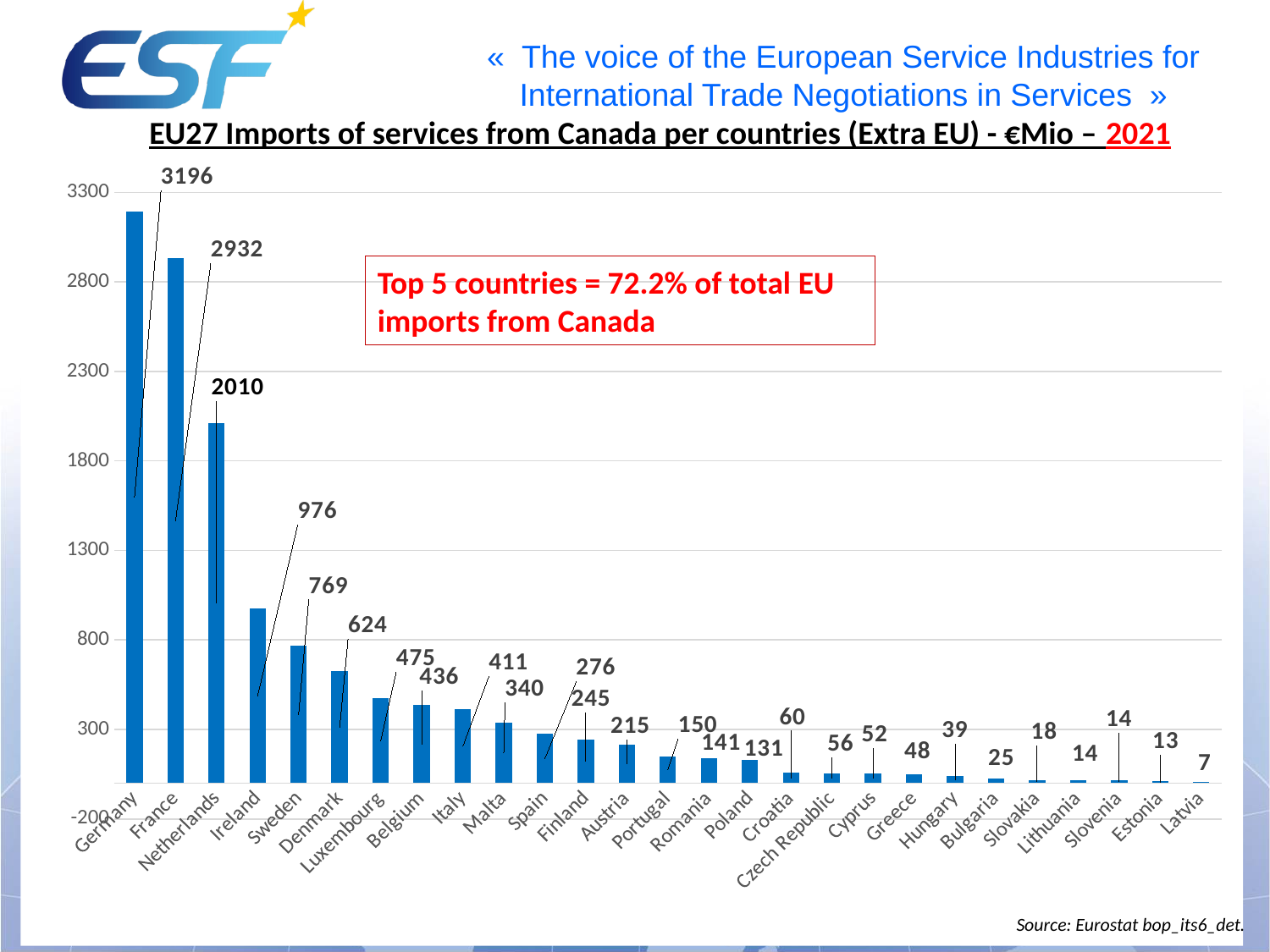
What is the difference between the values for Germany and France? 264 What is the value for Ireland? 976 Which country has the highest value? Germany How many countries are shown on the chart? 27 What kind of chart is this? Bar chart Do the values rise or fall from left to right along the x axis? Fall What is the difference between the values for Netherlands and Ireland? 1034 What is the value for Belgium? 436 Which is larger, the value for Sweden or the value for Denmark? Sweden What is the value for Germany? 3196 Which country has the lowest value? Latvia What is the value for Czech Republic? 56